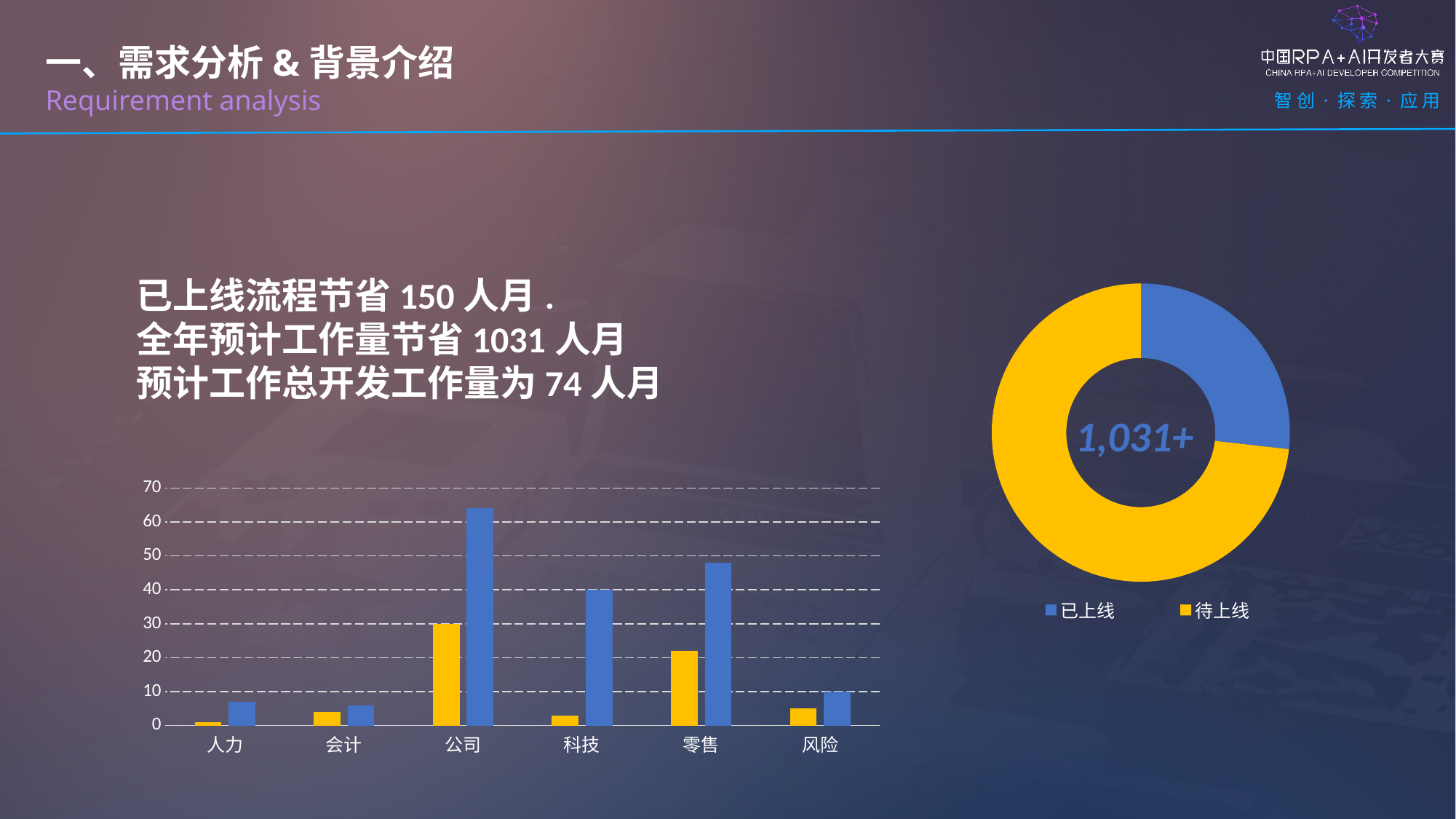
In the doughnut chart on the right, which slice is larger, 已上线 or 待上线? 待上线 In the bar chart at the bottom left, which has the taller blue bar, 科技 or 零售? 零售 In the bar chart at the bottom left, is the yellow bar for 公司 greater or less than 20? greater In the bar chart at the bottom left, which category has the tallest blue bar? 公司 What text is printed in the centre of the doughnut chart on the right? 1,031+ What kind of chart is the chart at the bottom left of the slide? bar chart In the doughnut chart on the right, how many entries does the legend list? 2 In the bar chart at the bottom left, is the yellow bar for 零售 greater or less than 20? greater In the bar chart at the bottom left, how many categories are shown on the x axis? 6 In the bar chart at the bottom left, which category has the shortest yellow bar? 人力 What kind of chart is the chart on the right of the slide? doughnut chart In the bar chart at the bottom left, is the blue bar for 公司 greater or less than 60? greater